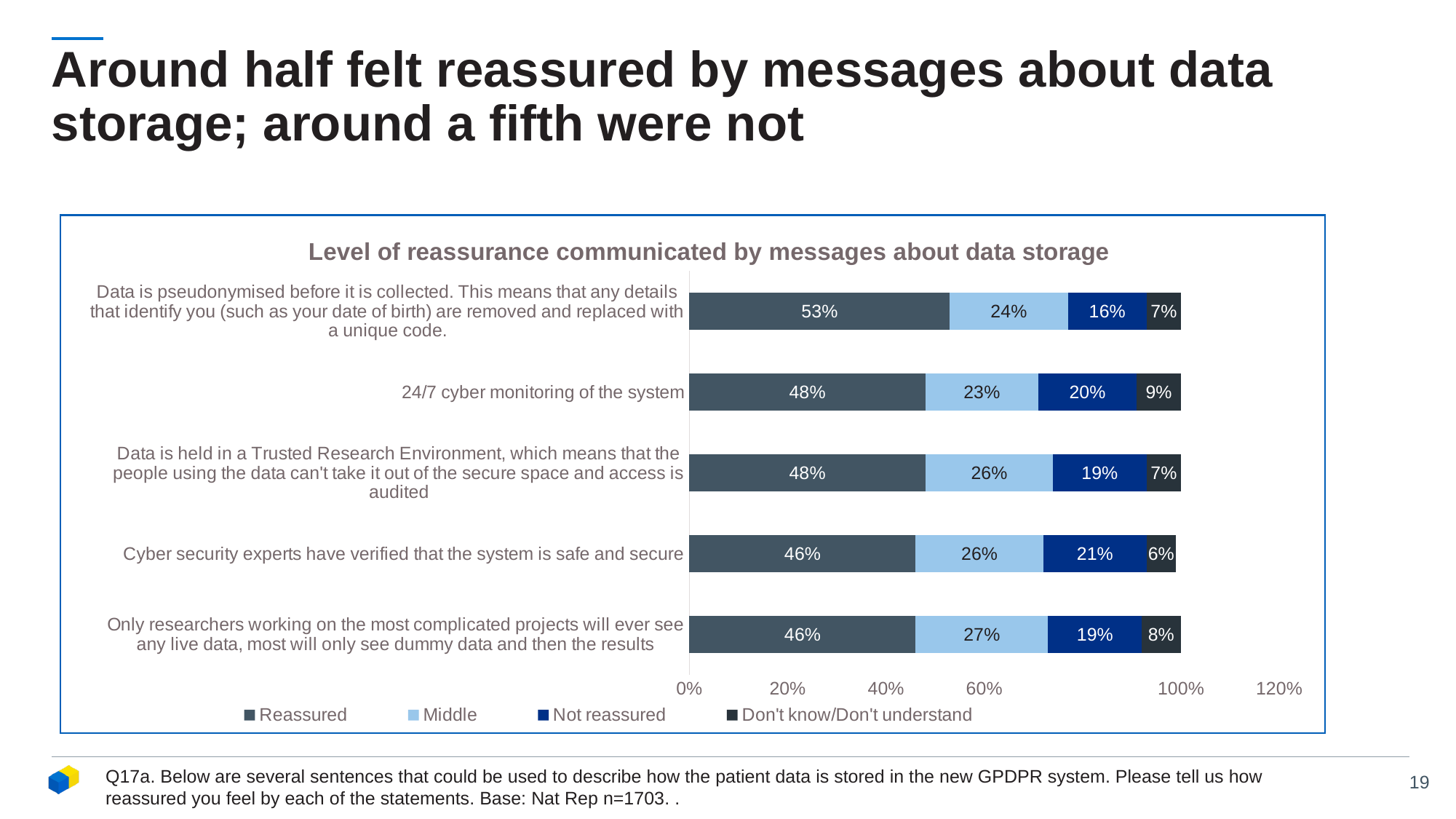
Which message has the highest 'Reassured' percentage? Data is pseudonymised before it is collected How many percentage points higher is the 'Reassured' value for the pseudonymised data message than for the 'Cyber security experts have verified' message? 7 percentage points How many messages (bars) are shown in the chart? 5 Which message has the highest 'Don't know/Don't understand' percentage? 24/7 cyber monitoring of the system What is the total of the labelled segments for the bar 'Cyber security experts have verified that the system is safe and secure'? 99% How many series does the legend list? 4 What percentage were not reassured by the message 'Cyber security experts have verified that the system is safe and secure'? 21% What percentage of respondents were reassured by the message '24/7 cyber monitoring of the system'? 48% Which message has the lowest 'Not reassured' percentage? Data is pseudonymised before it is collected What is the 'Don't know/Don't understand' value for the message about data being pseudonymised before it is collected? 7% Which has a larger 'Middle' share: 'Only researchers working on the most complicated projects will ever see any live data' or '24/7 cyber monitoring of the system'? Only researchers working on the most complicated projects will ever see any live data What type of chart is shown on the slide? Stacked bar chart